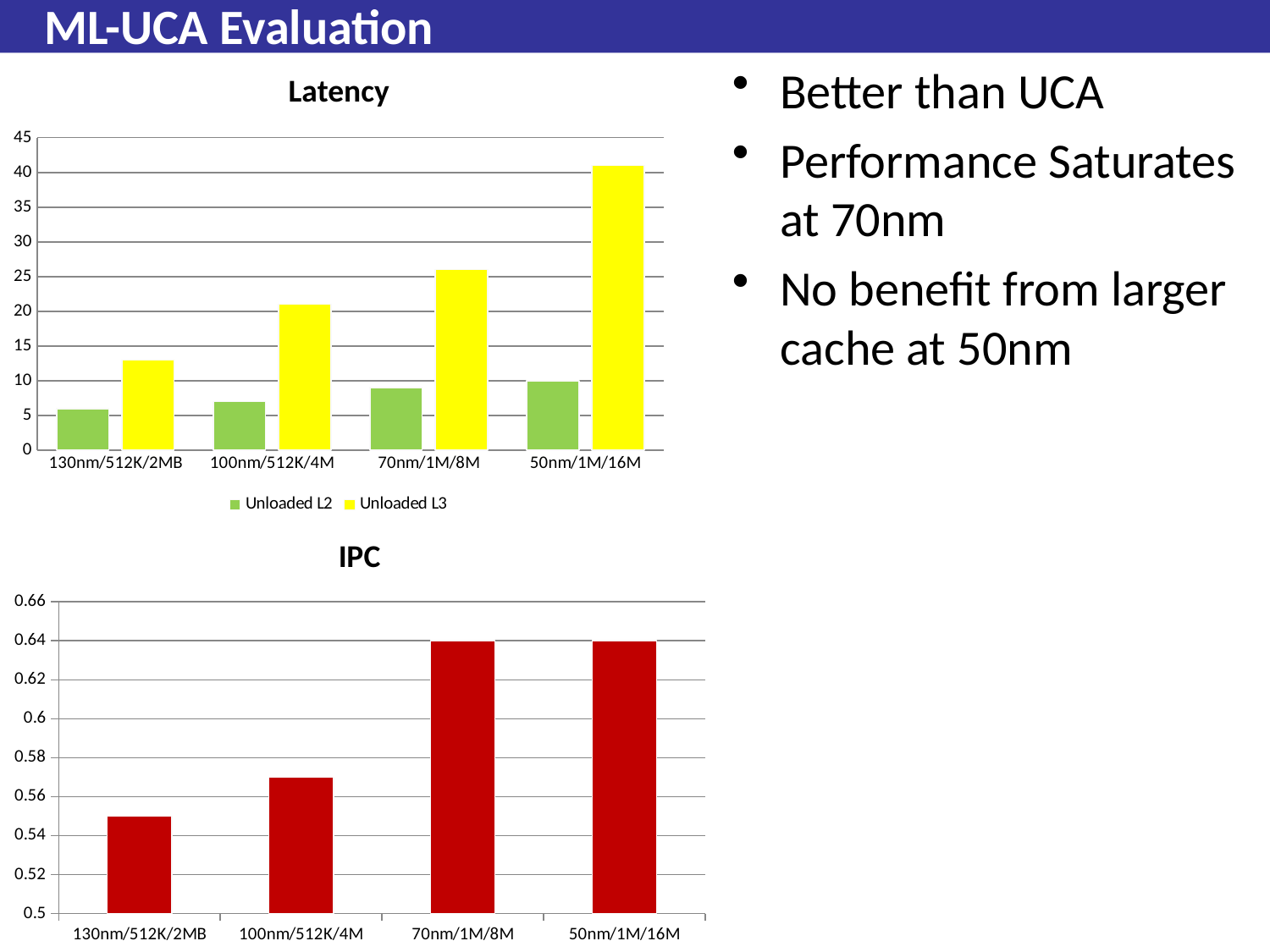
What are the two series named in the legend of the Latency chart? Unloaded L2 and Unloaded L3 In the Latency chart, is the Unloaded L3 value for 130nm/512K/2MB greater or less than 10? greater How many configurations are shown on the x axis of the Latency chart? 4 In the Latency chart, which configuration has the highest Unloaded L3 latency? 50nm/1M/16M How many series does the legend of the Latency chart list? 2 In the IPC chart, is the value for 100nm/512K/4M greater or less than 0.56? greater In the IPC chart, which configuration has the lowest IPC? 130nm/512K/2MB In the Latency chart, is the Unloaded L3 value for 50nm/1M/16M greater or less than 35? greater In the Latency chart, for 70nm/1M/8M, which is larger: Unloaded L2 or Unloaded L3? Unloaded L3 In the Latency chart, which configuration has the lowest Unloaded L3 latency? 130nm/512K/2MB What type of chart is the Latency chart? bar chart In the IPC chart, do the values rise or fall from 130nm/512K/2MB to 70nm/1M/8M? rise